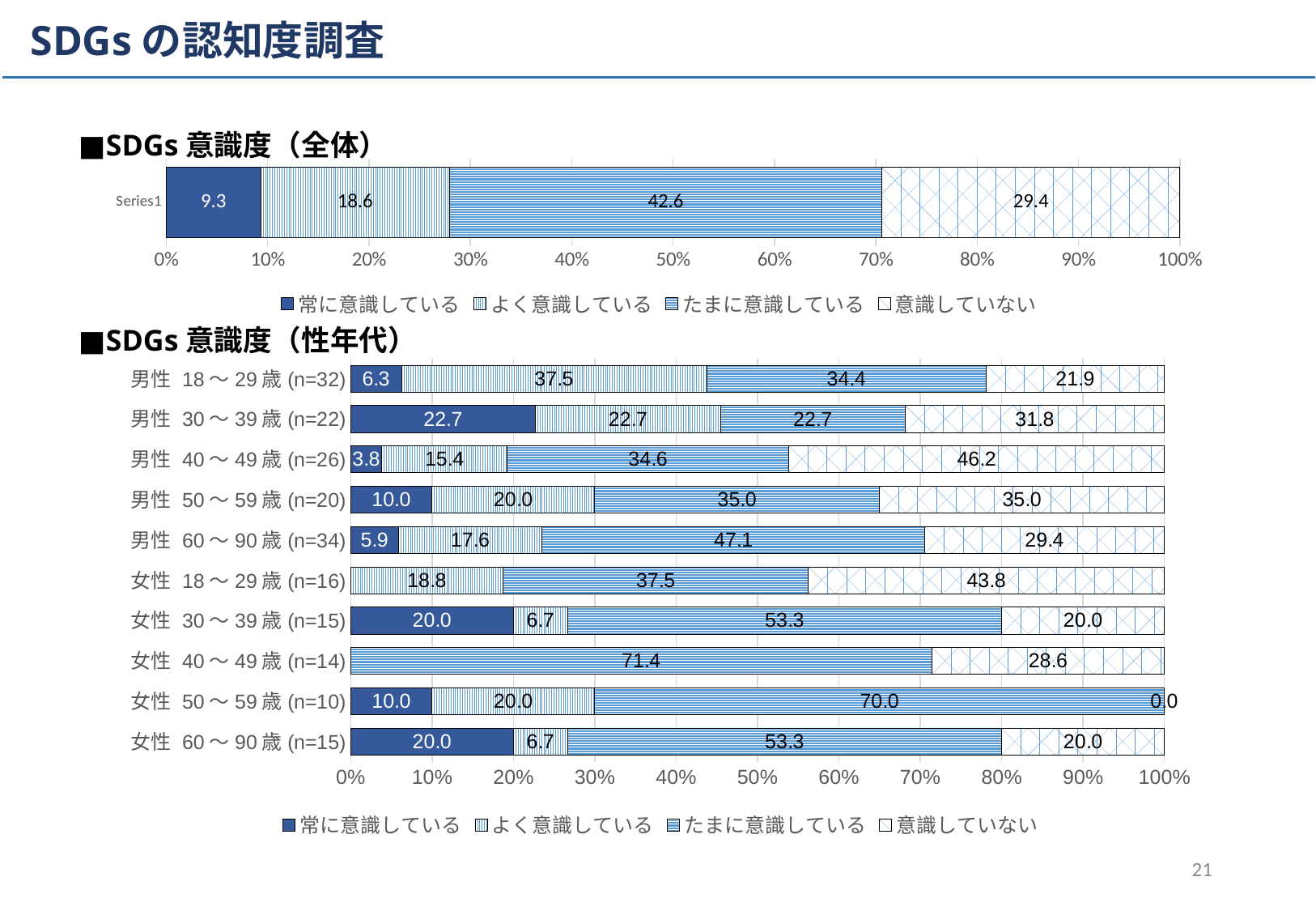
In the bottom chart (SDGs 意識度（性年代）), what is the 意識していない value for 男性 40〜49歳 (n=26)? 46.2 In the top chart (SDGs 意識度（全体）), what is the difference between たまに意識している and 意識していない? 13.2 How many series does the legend of the bottom chart (SDGs 意識度（性年代）) list? 4 In the bottom chart (SDGs 意識度（性年代）), what is the たまに意識している value for 女性 40〜49歳 (n=14)? 71.4 How many groups (bars) are shown in the bottom chart (SDGs 意識度（性年代）)? 10 In the top chart (SDGs 意識度（全体）), which segment is the largest? たまに意識している In the bottom chart (SDGs 意識度（性年代）), what is the 意識していない value for 女性 50〜59歳 (n=10)? 0.0 In the bottom chart (SDGs 意識度（性年代）), which group has the highest 意識していない value? 男性 40〜49歳 (n=26) In the bottom chart (SDGs 意識度（性年代）), which is larger: the たまに意識している value for 男性 60〜90歳 (n=34) or for 女性 30〜39歳 (n=15)? 女性 30〜39歳 (n=15) What kind of chart is the bottom chart (SDGs 意識度（性年代）)? Stacked bar chart In the top chart (SDGs 意識度（全体）), what is the value for たまに意識している? 42.6 In the bottom chart (SDGs 意識度（性年代）), which group has the highest 常に意識している value? 男性 30〜39歳 (n=22)